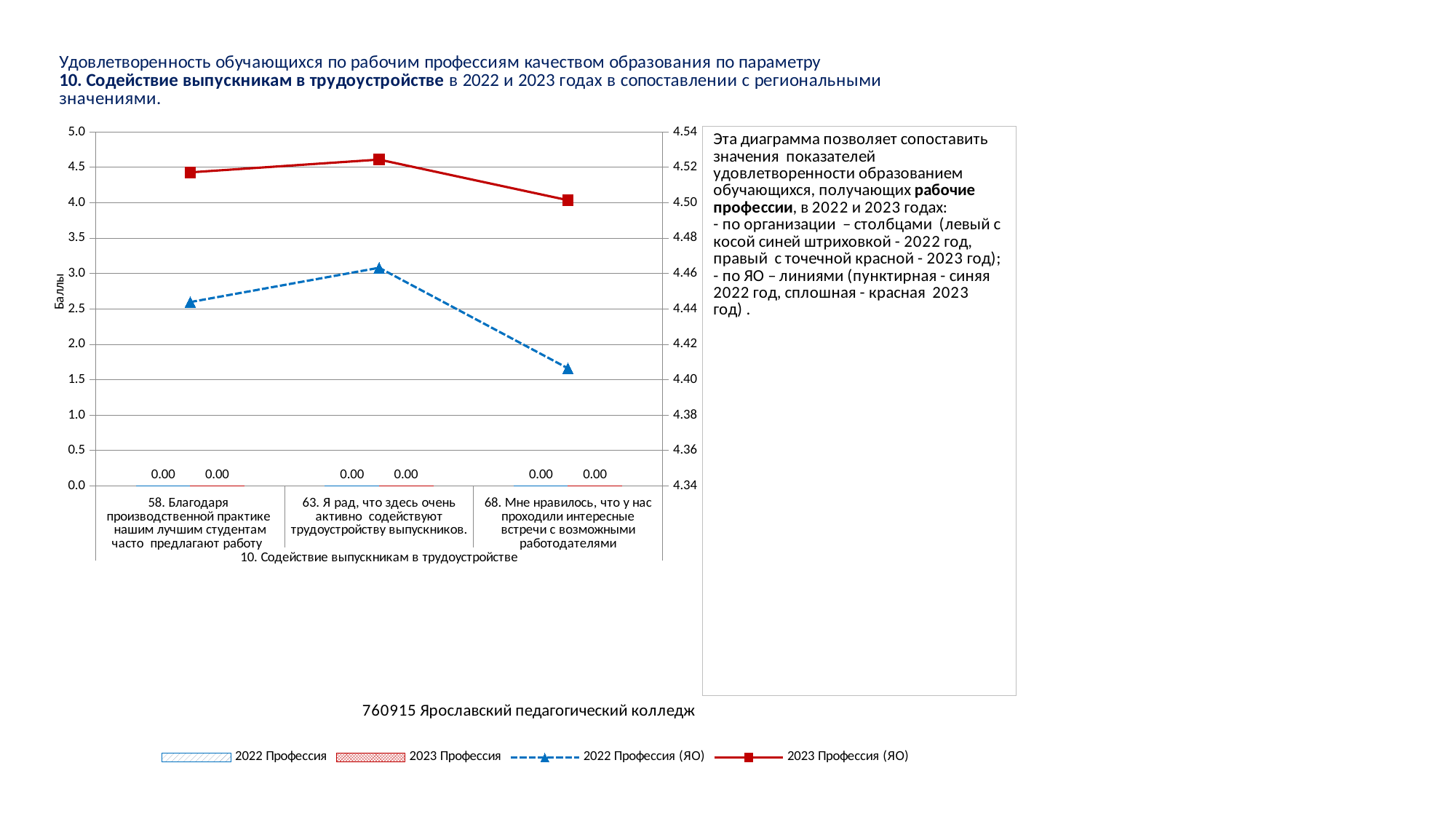
Does the 2022 Профессия (ЯО) line rise or fall from category 63 to category 68? fall For which category is the 2022 Профессия (ЯО) line lowest? 68. Мне нравилось, что у нас проходили интересные встречи с возможными работодателями How many series does the legend list? 4 For which category is the 2023 Профессия (ЯО) line highest? 63. Я рад, что здесь очень активно содействуют трудоустройству выпускников. How many categories are shown on the x axis? 3 What is the value of the 2023 Профессия bar for category 68 (Мне нравилось, что у нас проходили интересные встречи с возможными работодателями)? 0.00 What is the title shown below the chart? 760915 Ярославский педагогический колледж What kind of chart is this? Combined bar and line chart Is the value of 2023 Профессия (ЯО) for category 58 greater or less than 4.50 on the right axis? greater For category 68, which series is larger: 2022 Профессия (ЯО) or 2023 Профессия (ЯО)? 2023 Профессия (ЯО) What is the value of the 2022 Профессия bar for category 58 (Благодаря производственной практике нашим лучшим студентам часто предлагают работу)? 0.00 Is the value of 2022 Профессия (ЯО) for category 68 greater or less than 4.42 on the right axis? less